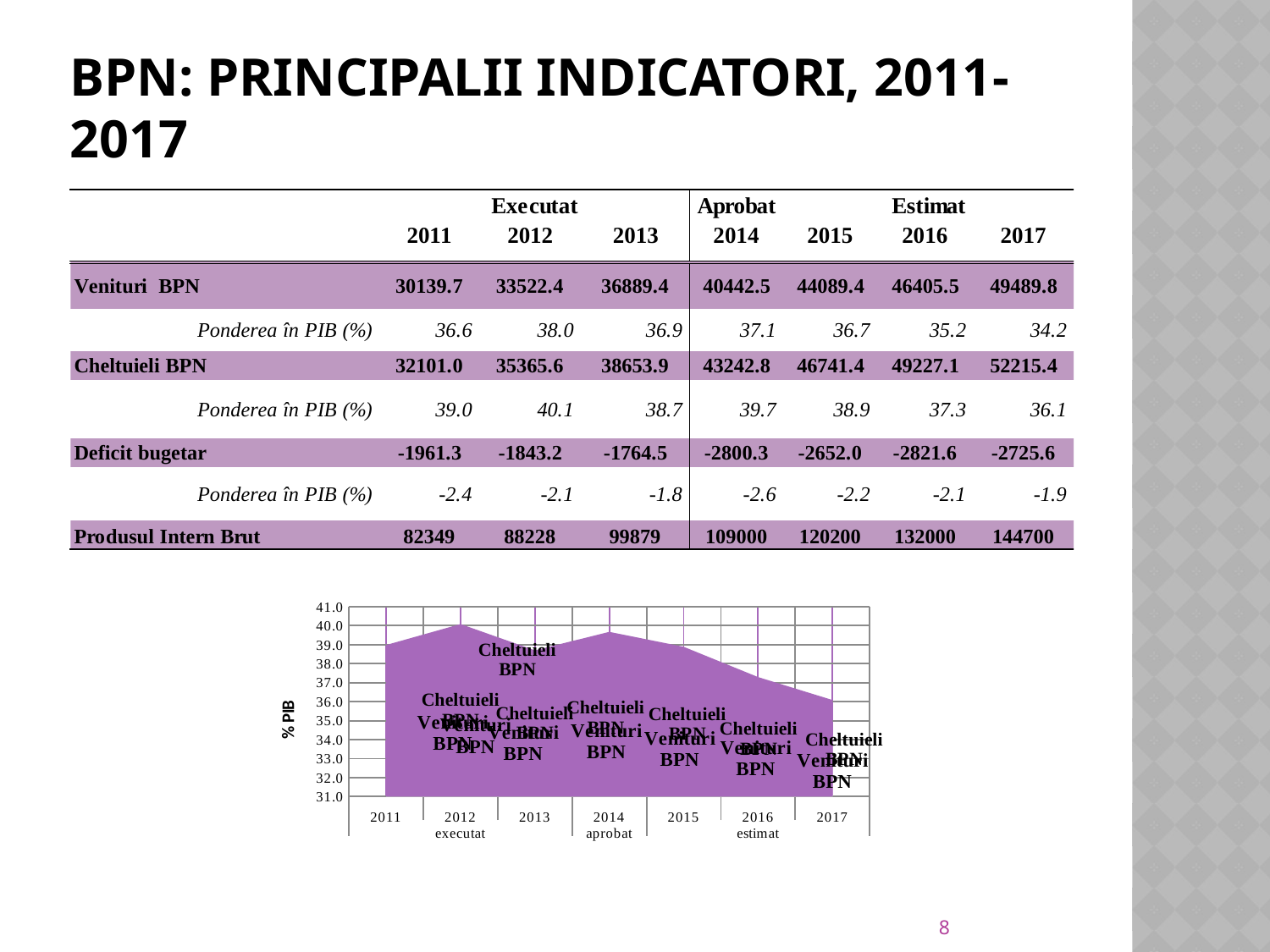
In which year does the Cheltuieli BPN area reach its highest point on the chart? 2012 Is the Cheltuieli BPN value for 2014 on the chart greater or less than 39.0? greater Is the Cheltuieli BPN value for 2016 on the chart greater or less than 38.0? less In which year does the Cheltuieli BPN area reach its lowest point on the chart? 2017 Which years on the chart's x axis are grouped under "estimat"? 2015, 2016, 2017 What kind of chart is shown at the bottom of the slide? area chart How many years are shown along the x axis of the chart? 7 Does the Cheltuieli BPN area on the chart rise or fall from 2014 to 2017? fall Which is higher on the chart, the Cheltuieli BPN value for 2011 or for 2017? 2011 Is the Cheltuieli BPN value for 2017 on the chart greater or less than 37.0? less What is the label on the vertical axis of the chart? % PIB